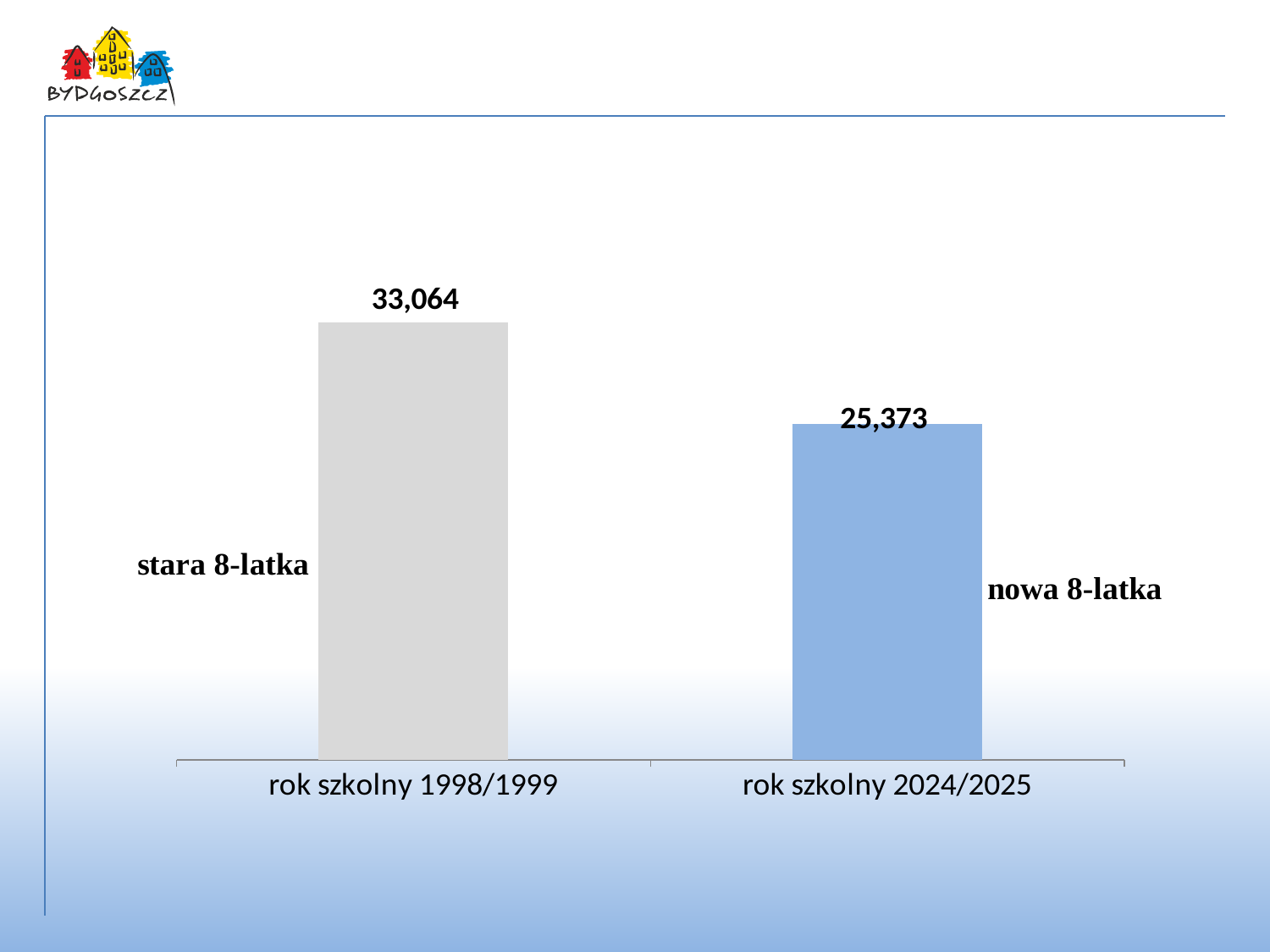
How many categories are shown on the x axis? 2 Which category has the lowest value? rok szkolny 2024/2025 Do the values rise or fall from rok szkolny 1998/1999 to rok szkolny 2024/2025? fall What is the difference between the values for rok szkolny 1998/1999 and rok szkolny 2024/2025? 7,691 What text label is placed next to the bar for rok szkolny 2024/2025? nowa 8-latka Which category has the highest value? rok szkolny 1998/1999 What text label is placed next to the bar for rok szkolny 1998/1999? stara 8-latka What kind of chart is shown on the slide? bar chart Which is larger, the value for rok szkolny 1998/1999 or the value for rok szkolny 2024/2025? rok szkolny 1998/1999 What is the value shown for rok szkolny 2024/2025? 25,373 What is the value shown for rok szkolny 1998/1999? 33,064